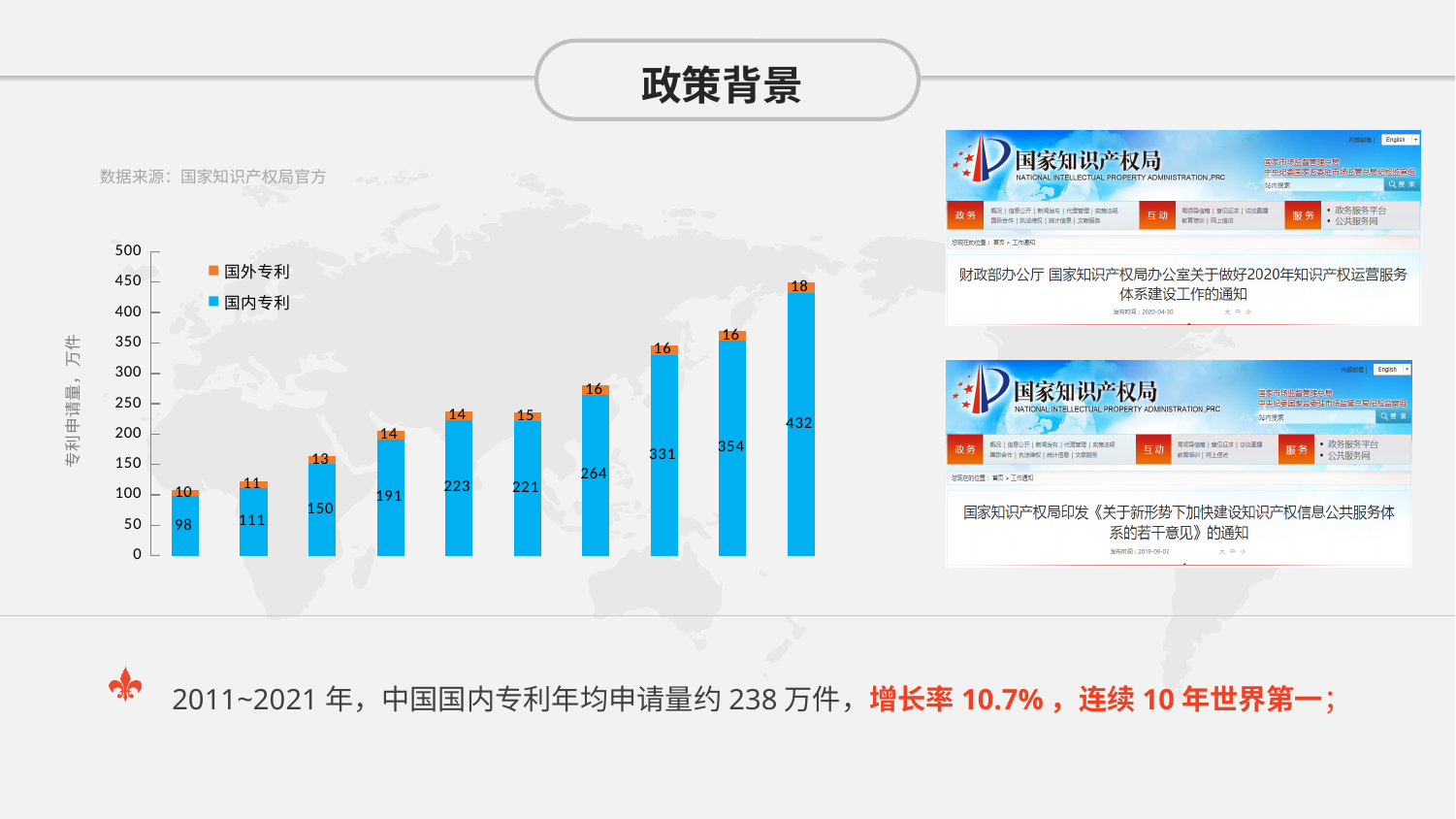
Which colour represents 国外专利 in the legend? orange What is the total of the last (rightmost) stacked bar? 450 Which bar has the highest 国内专利 value? the last (rightmost) bar What is the 国内专利 value for the first (leftmost) bar? 98 How many bars are plotted in the chart? 10 What is the 国外专利 value for the last (rightmost) bar? 18 What kind of chart is shown on the slide? stacked bar chart What is the difference between the 国内专利 values of the last bar (432) and the first bar (98)? 334 How many series does the chart legend list? 2 Do the 国内专利 values generally rise or fall from left to right? rise Which is larger, the 国内专利 value of the fifth bar or the sixth bar? the fifth bar (223) Which bar has the lowest 国内专利 value? the first (leftmost) bar